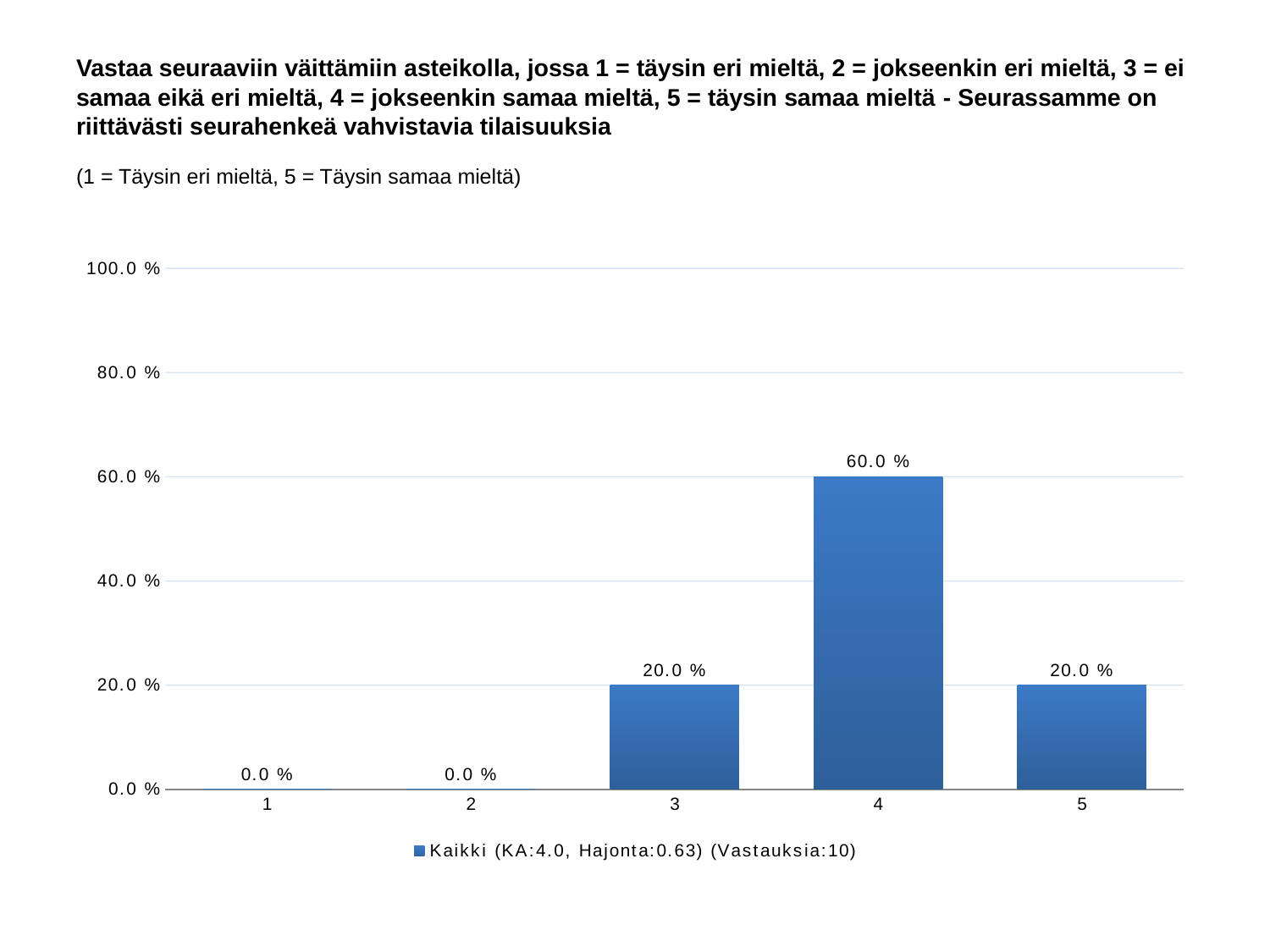
What is the value for category 1? 0.0 % Which is larger, the value for category 3 or the value for category 4? 4 How many series does the legend list? 1 How many categories are shown on the x axis? 5 What is the value for category 3? 20.0 % How many categories have a value of 0.0 %? 2 What is the value for category 4? 60.0 % What kind of chart is shown on the slide? bar chart Is the value for category 4 greater or less than 40.0 %? greater Which category has the highest value? 4 What is the legend entry for the series? Kaikki (KA:4.0, Hajonta:0.63) (Vastauksia:10) What is the difference between the values for category 4 and category 5? 40.0 %